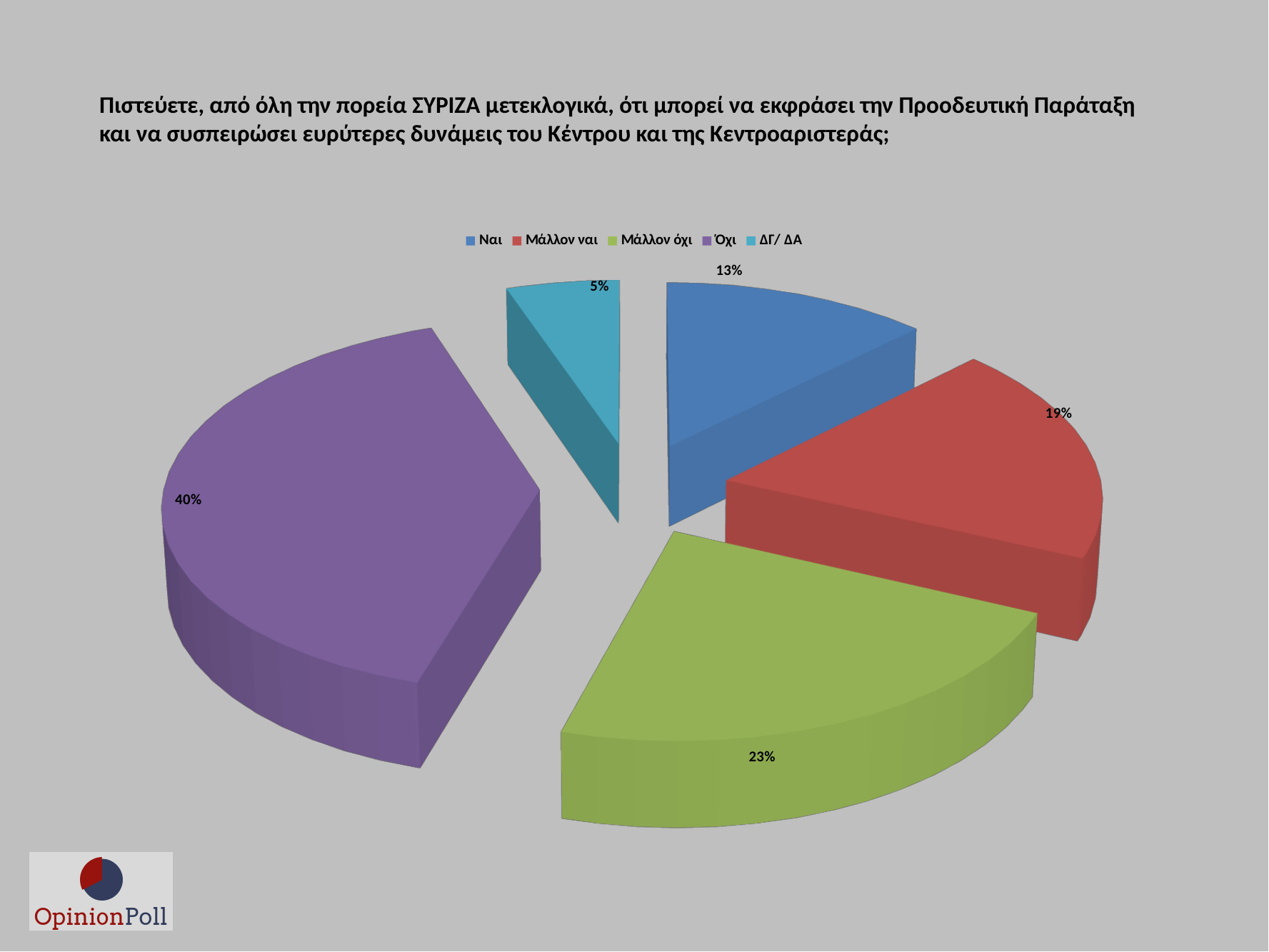
How many categories does the legend list? 5 What kind of chart is shown on the slide? Pie chart What is the difference in percentage points between 'Όχι' and 'Ναι'? 27 Which category has the largest share of the pie? Όχι What percentage is shown for the 'ΔΓ/ ΔΑ' slice? 5% What colour is the 'Όχι' slice? Purple What percentage is shown for the 'Μάλλον όχι' slice? 23% Which is larger, the share for 'Μάλλον ναι' or the share for 'Μάλλον όχι'? Μάλλον όχι Which category has the smallest share of the pie? ΔΓ/ ΔΑ What percentage is shown for the 'Ναι' slice? 13% What percentage is shown for the 'Όχι' slice? 40% What percentage is shown for the 'Μάλλον ναι' slice? 19%